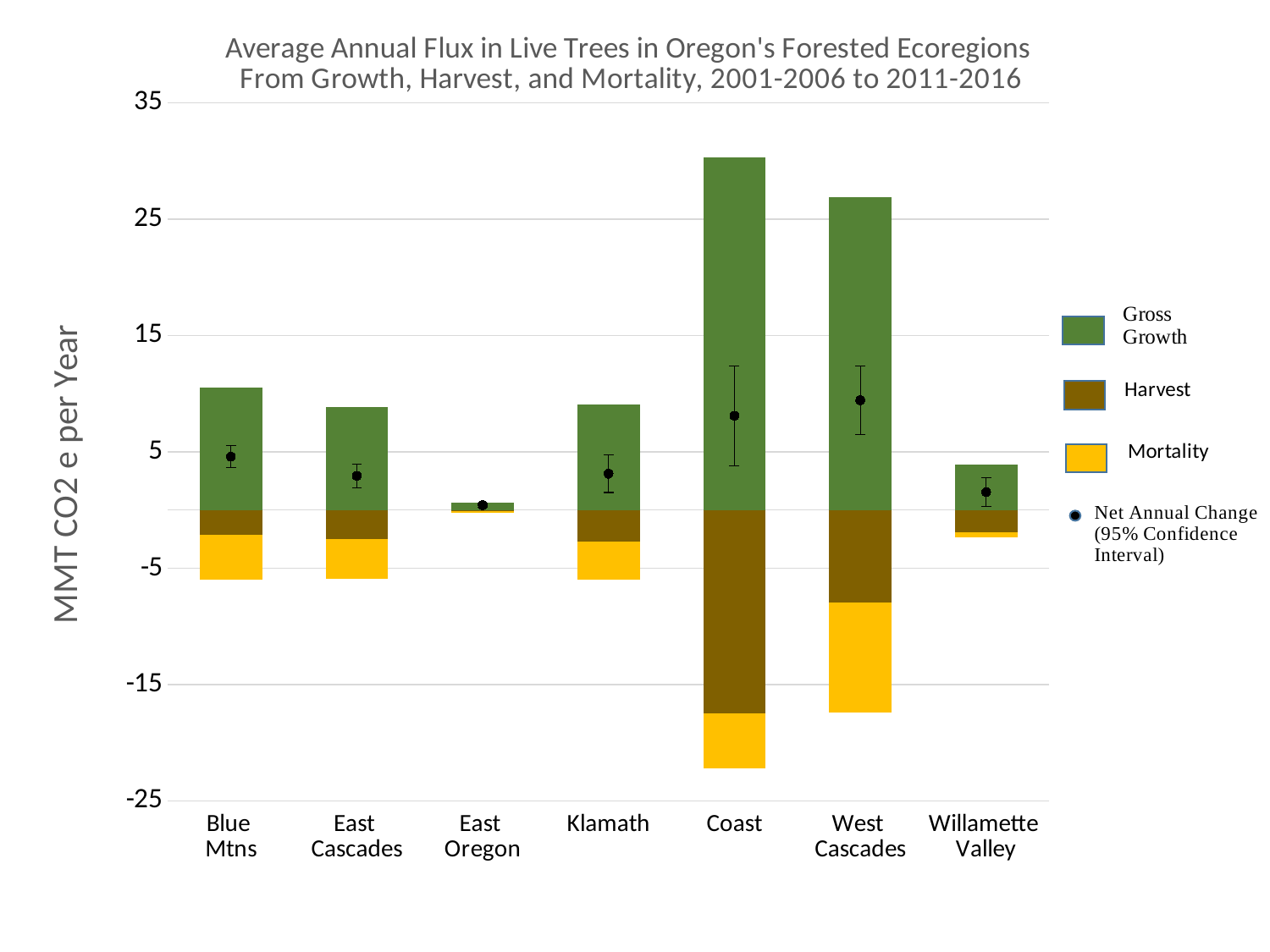
Which has the larger Mortality segment, Coast or West Cascades? West Cascades How many ecoregions (categories) are shown on the x axis? 7 What kind of chart is shown on the slide? Stacked bar chart Which ecoregion has the highest Gross Growth value? Coast Is the Gross Growth value for Blue Mtns greater or less than 5? greater How many entries does the legend list? 4 What is the label of the y axis? MMT CO2 e per Year Which ecoregion has the largest Harvest flux (the longest Harvest segment)? Coast Is the Gross Growth value for Coast greater or less than 25? greater Which ecoregion has the lowest Gross Growth value? East Oregon Is the Gross Growth value for East Oregon greater or less than 5? less Which has the larger Gross Growth value, Coast or West Cascades? Coast